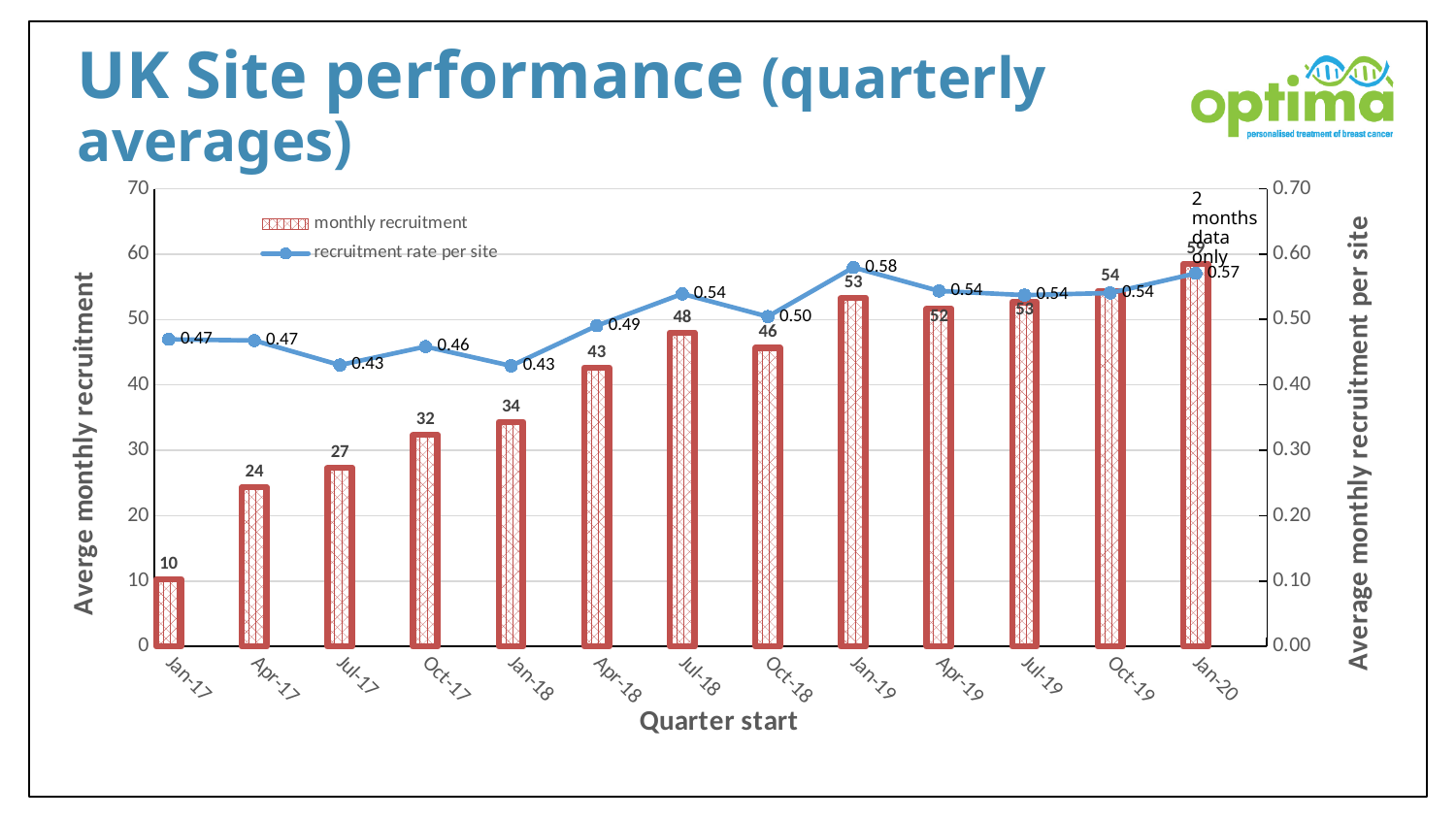
How many quarters are shown on the x axis? 13 What is the recruitment rate per site for Jan-19? 0.58 Which quarter has the lowest monthly recruitment? Jan-17 What is the recruitment rate per site for Apr-18? 0.49 Is the monthly recruitment for Oct-17 greater or less than 30? greater What is the monthly recruitment value for Jan-17? 10 Does monthly recruitment generally rise or fall from Jan-17 to Jan-20? Rise How many series does the legend list? 2 What kind of chart is shown on the slide? Combined bar and line chart What is the difference in monthly recruitment between Jul-18 and Oct-18? 2 Which quarter has the highest recruitment rate per site? Jan-19 Which has the higher monthly recruitment, Apr-19 or Jul-19? Jul-19